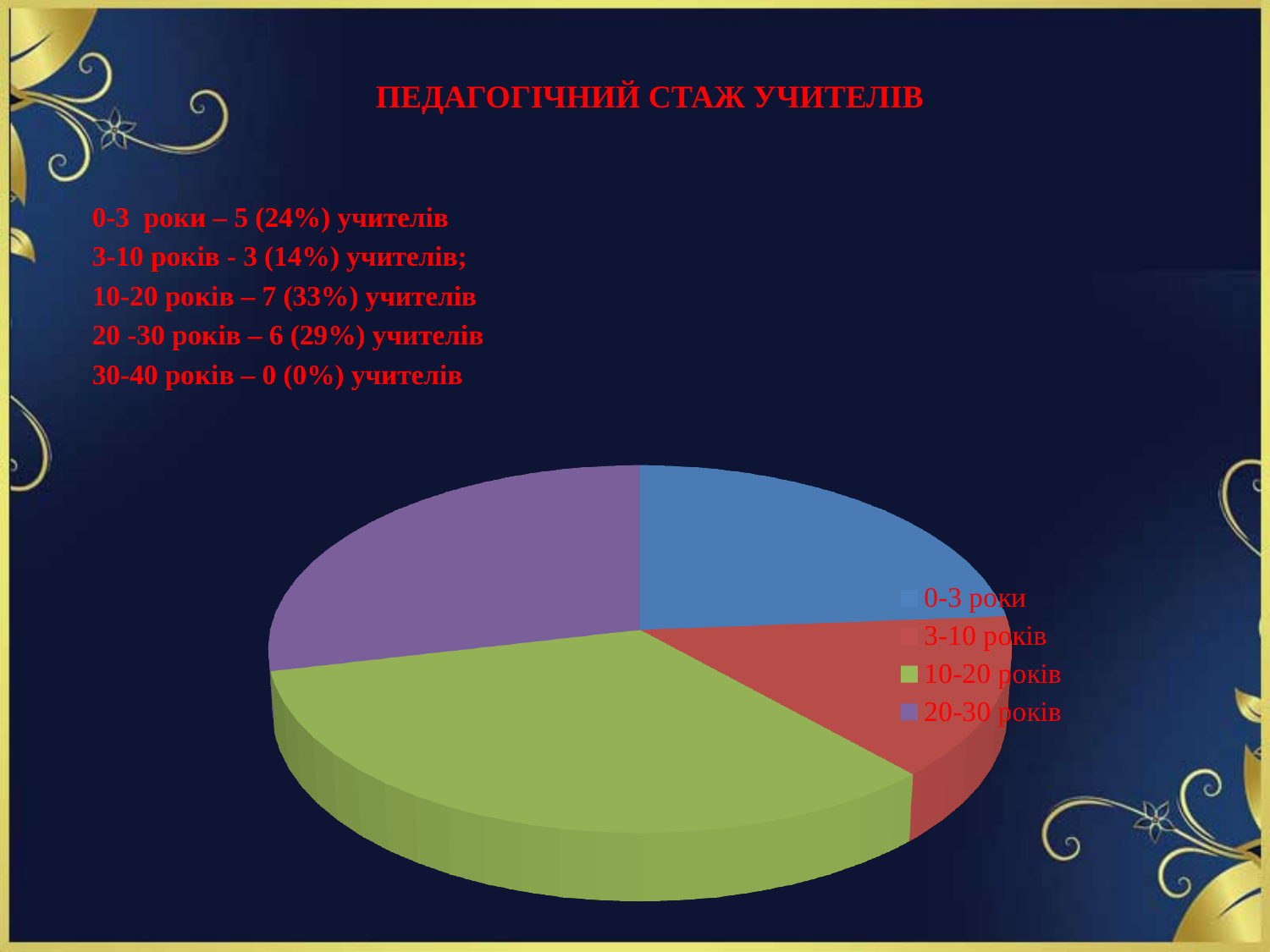
How many slices does the pie chart have? 4 What is the difference in the number of teachers between the 10-20 років and 3-10 років categories? 4 Which slice is larger: 0-3 роки or 3-10 років? 0-3 роки How many teachers have 20-30 років of experience, according to the slide text? 6 What colour is the slice for 10-20 років in the pie chart? green Which category has the largest slice of the pie chart? 10-20 років What share of the pie does the 0-3 роки category represent, according to the slide text? 24% How many entries does the legend of the pie chart list? 4 Which category has the smallest slice of the pie chart? 3-10 років What is the title of the slide with the pie chart? ПЕДАГОГІЧНИЙ СТАЖ УЧИТЕЛІВ What kind of chart is shown on the slide? pie chart What share of the pie does the 10-20 років category represent, according to the slide text? 33%